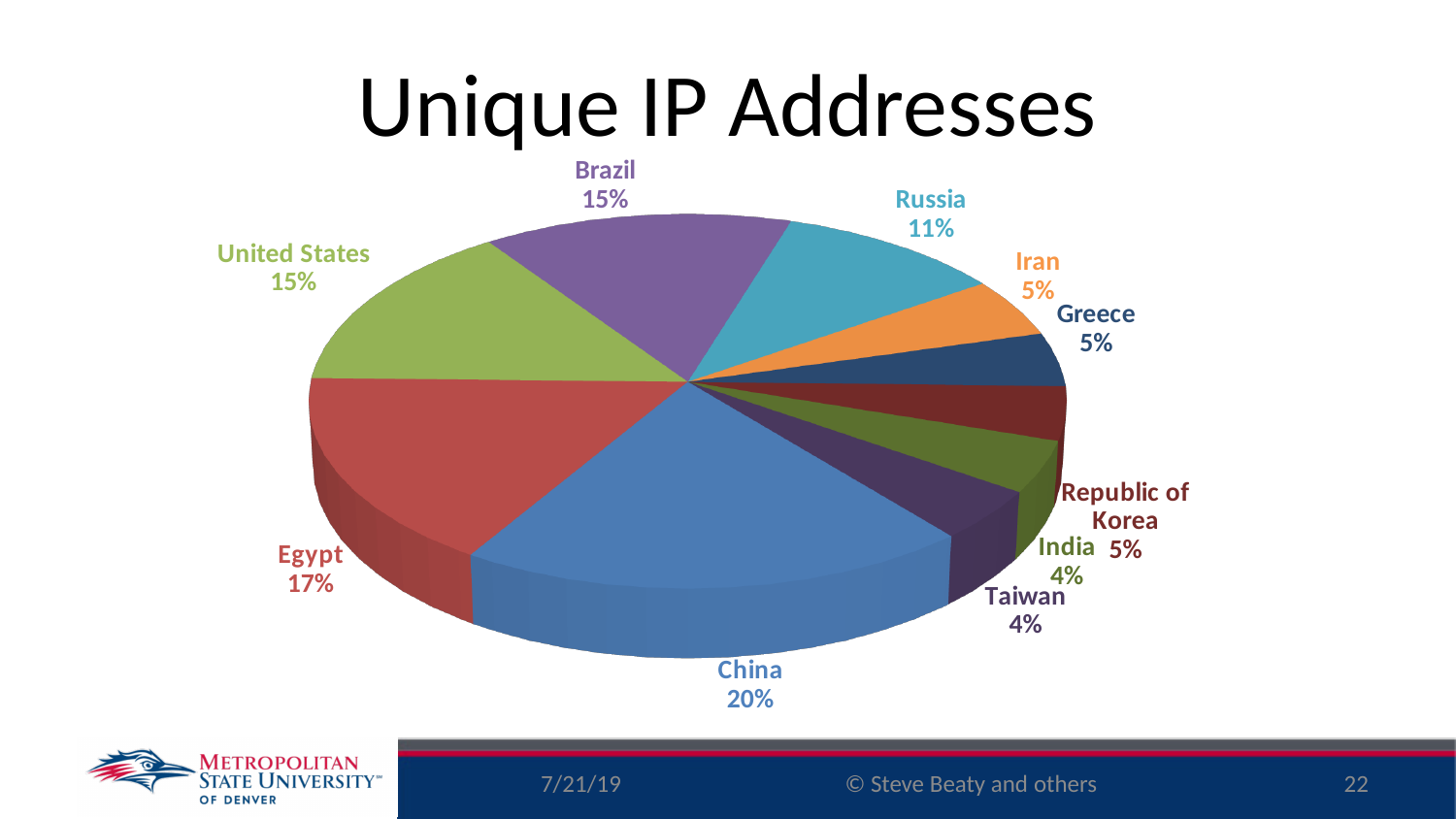
What is the difference in percentage points between China and Egypt? 3 Which is larger, the share for Brazil or the share for Russia? Brazil What percentage is shown for the Republic of Korea? 5% What is the combined share of the United States and Brazil? 30% What percentage is shown for Russia? 11% What kind of chart is shown on the slide? pie chart Which country has the largest slice of the pie? China How many countries are shown in the pie chart? 10 What percentage is shown for Egypt? 17% What is the title of the chart? Unique IP Addresses What percentage is shown for Taiwan? 4% What share of unique IP addresses does China account for? 20%